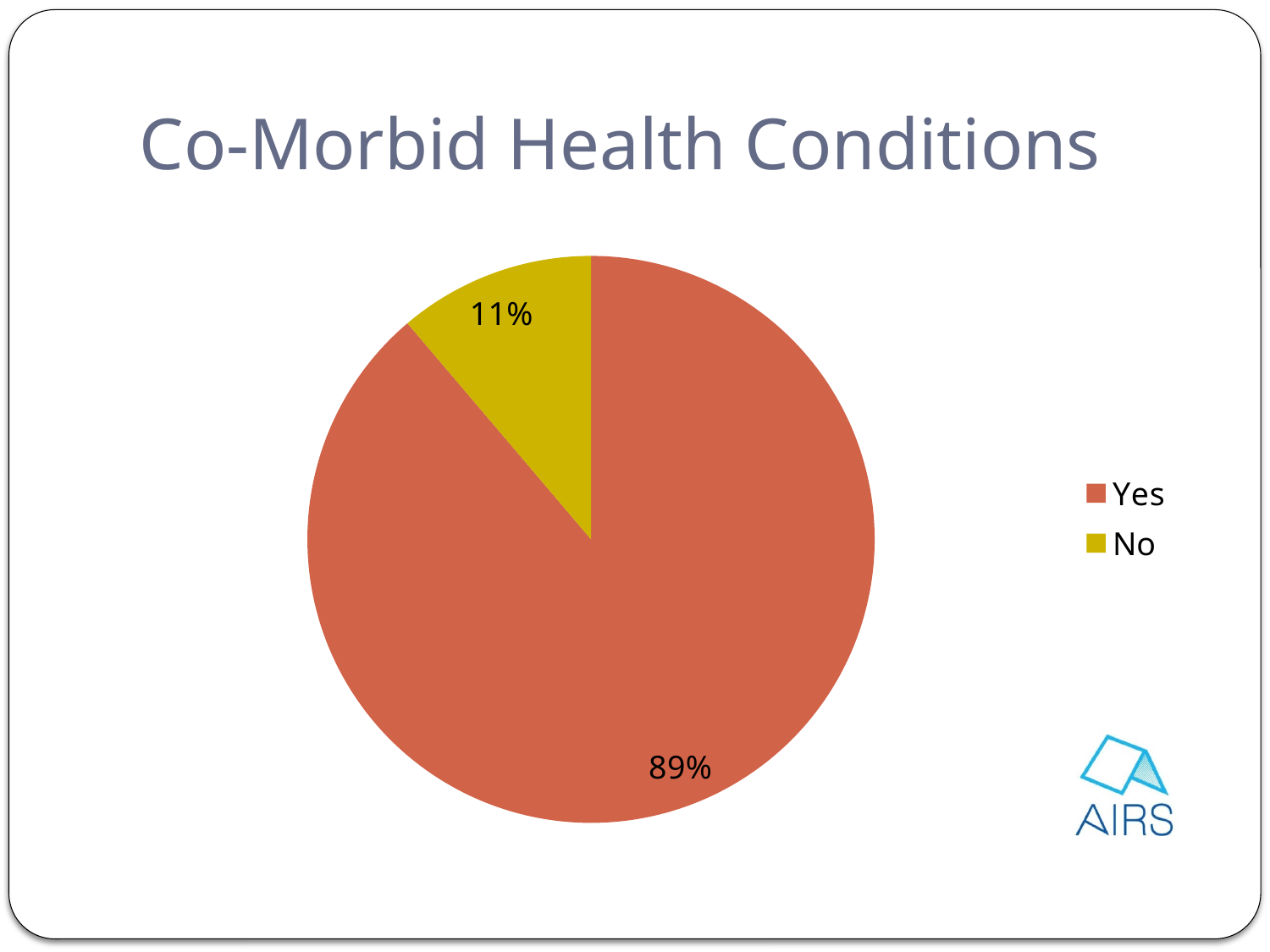
Which is larger, the "Yes" slice or the "No" slice? Yes How many slices does the pie chart have? 2 What kind of chart is shown on the slide? pie chart What is the difference in percentage points between the "Yes" and "No" slices? 78 What is the title of the slide containing the chart? Co-Morbid Health Conditions Which slice of the pie is the largest? Yes What colour is the "No" slice of the pie? yellow What share of the pie is labelled "Yes"? 89% Which slice of the pie is the smallest? No What share of the pie is labelled "No"? 11% How many entries does the legend list? 2